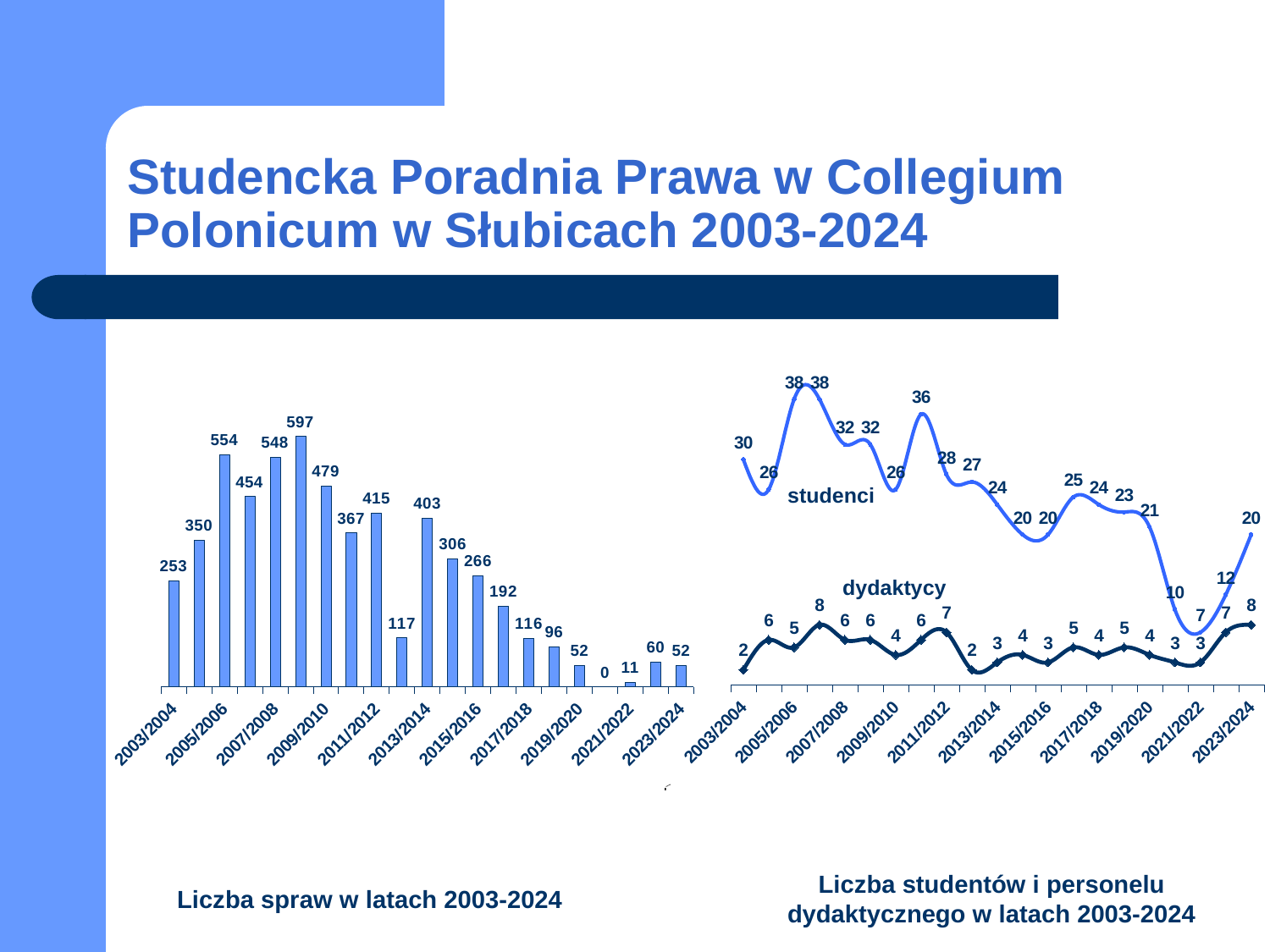
In the right chart 'Liczba studentów i personelu dydaktycznego w latach 2003-2024', what is the value for studenci in 2003/2004? 30 In the left chart 'Liczba spraw w latach 2003-2024', what is the difference between the highest value (597) and the value for 2003/2004 (253)? 344 In the left chart 'Liczba spraw w latach 2003-2024', what is the value for 2005/2006? 554 In the left chart 'Liczba spraw w latach 2003-2024', what is the highest value shown? 597 In the right chart 'Liczba studentów i personelu dydaktycznego w latach 2003-2024', what is the value for dydaktycy in 2023/2024? 8 In the left chart 'Liczba spraw w latach 2003-2024', what is the value for 2003/2004? 253 How many series does the right chart 'Liczba studentów i personelu dydaktycznego w latach 2003-2024' show? 2 In the right chart 'Liczba studentów i personelu dydaktycznego w latach 2003-2024', what is the difference between studenci (30) and dydaktycy (2) in 2003/2004? 28 In the right chart 'Liczba studentów i personelu dydaktycznego w latach 2003-2024', what is the highest value of the studenci series? 38 In the left chart 'Liczba spraw w latach 2003-2024', what is the lowest value shown? 0 In the left chart 'Liczba spraw w latach 2003-2024', which is larger: the bar labelled 554 or the bar labelled 548? 554 What kind of chart is the left chart, 'Liczba spraw w latach 2003-2024'? bar chart